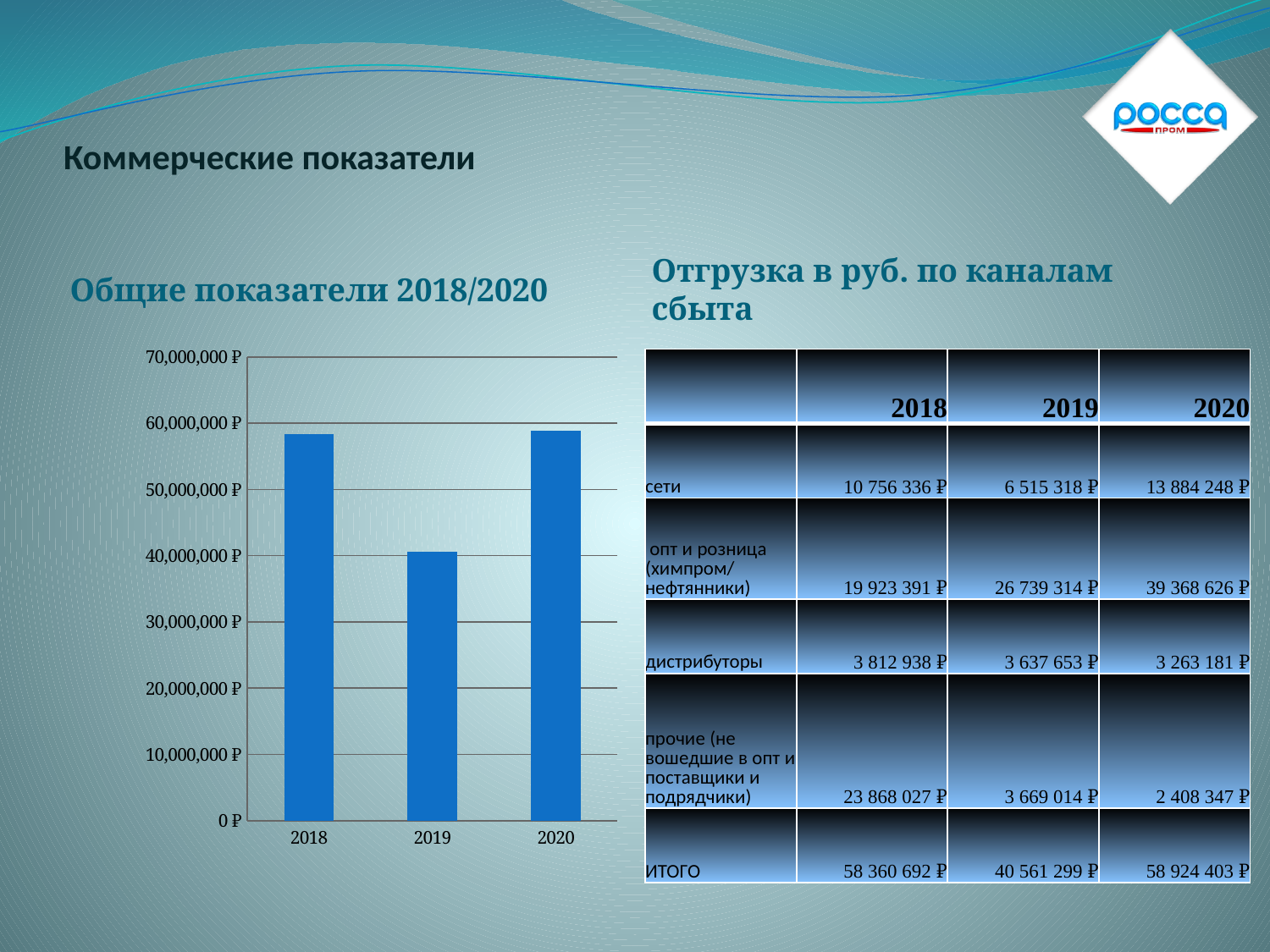
Does the value in the chart rise or fall from 2018 to 2019? fall Is the value for 2019 in the chart greater or less than 30,000,000 ₽? greater Is the value for 2018 in the chart greater or less than 50,000,000 ₽? greater Is the value for 2020 in the chart greater or less than 60,000,000 ₽? less How many years (categories) are plotted on the x axis of the bar chart? 3 Which bar is taller in the chart, 2019 or 2020? 2020 What kind of chart is shown under the heading "Общие показатели 2018/2020"? bar chart Which bar is taller in the chart, 2018 or 2019? 2018 Which year has the lowest bar in the chart? 2019 What is the highest tick value shown on the y axis of the chart? 70,000,000 ₽ What is the title of the bar chart on the slide? Общие показатели 2018/2020